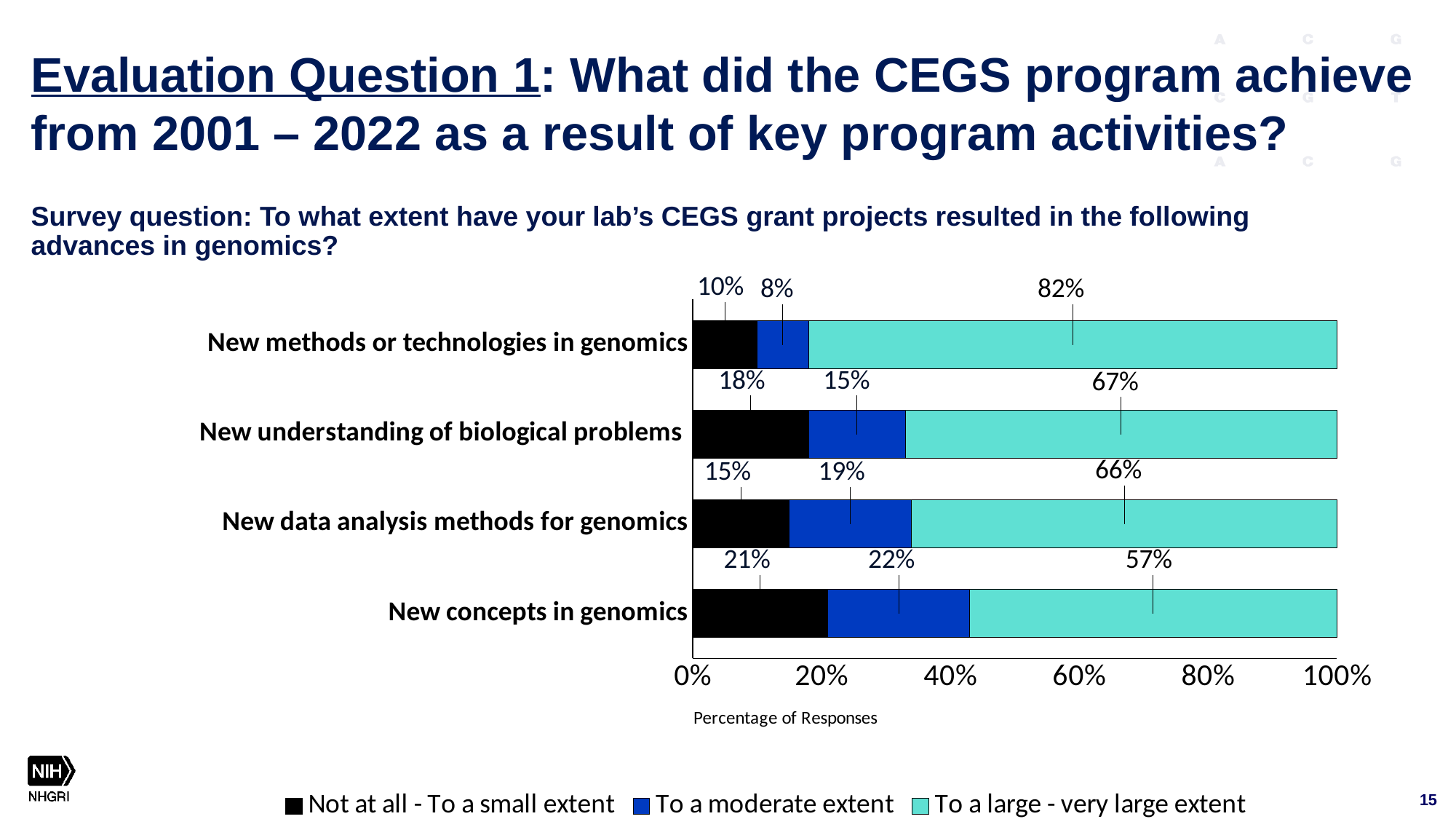
Which category has the lowest 'To a large - very large extent' percentage? New concepts in genomics What kind of chart is shown on the slide? Stacked bar chart What is the label of the x axis of the chart? Percentage of Responses How many series does the legend list? 3 What percentage of responses were 'To a large - very large extent' for New understanding of biological problems? 67% What percentage of responses were 'To a large - very large extent' for New methods or technologies in genomics? 82% Which is larger: the 'Not at all - To a small extent' share for New understanding of biological problems or for New data analysis methods for genomics? New understanding of biological problems How many categories are shown on the y axis of the chart? 4 What percentage of responses were 'To a moderate extent' for New data analysis methods for genomics? 19% What is the difference between the 'To a large - very large extent' percentages for New methods or technologies in genomics and New concepts in genomics? 25% What percentage of responses were 'Not at all - To a small extent' for New concepts in genomics? 21% Which category has the highest 'To a large - very large extent' percentage? New methods or technologies in genomics